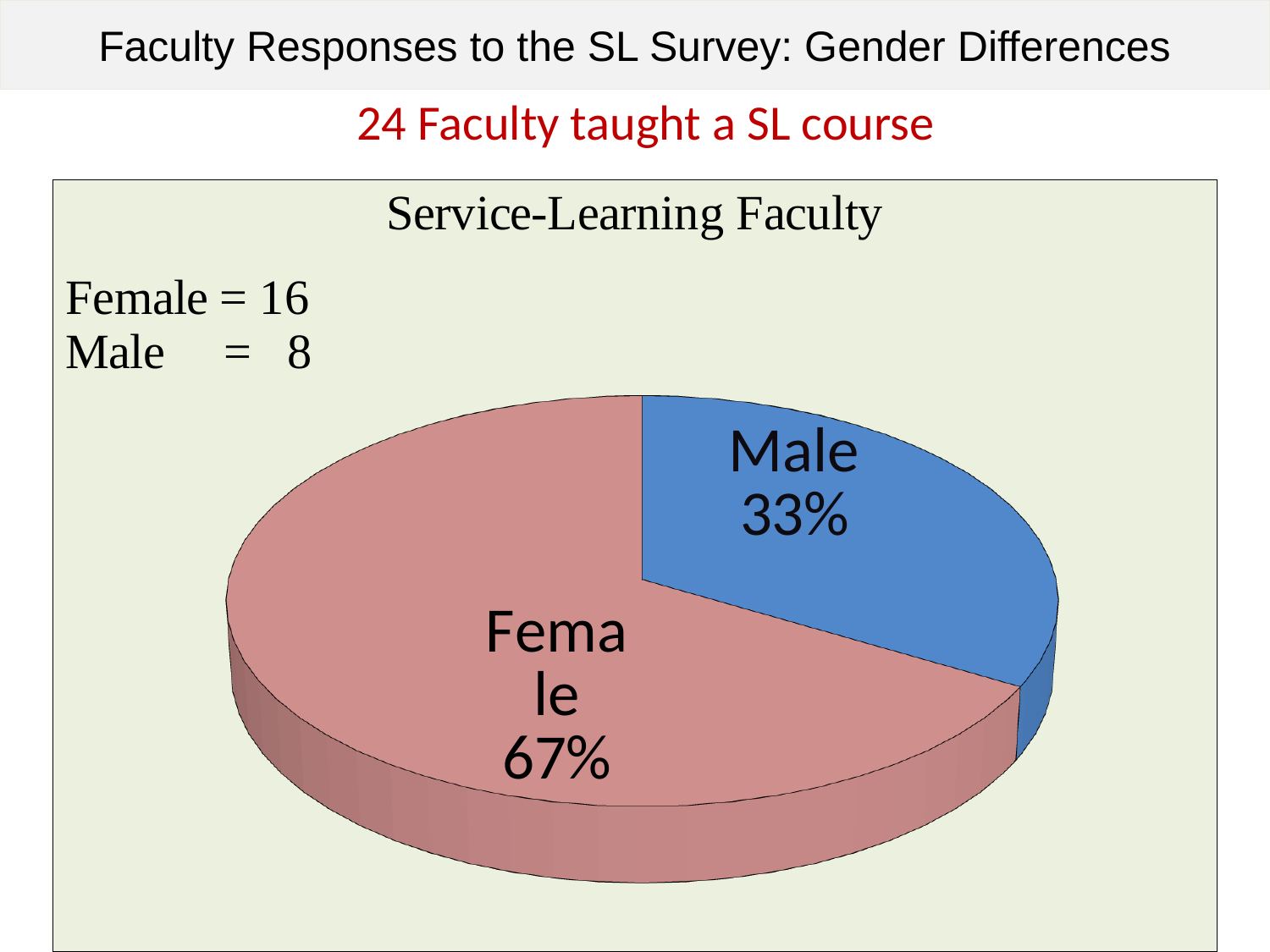
What share of the pie does the Male slice represent? 33% Which slice is larger, Female or Male? Female How many faculty are counted as Female according to the text in the chart area? 16 What share of the pie does the Female slice represent? 67% What colour is the Male slice of the pie chart? blue Which slice is the largest in the pie chart? Female What is the difference in percentage points between the Female and Male slices? 34 How many slices does the pie chart have? 2 How many faculty are counted as Male according to the text in the chart area? 8 What kind of chart is shown on the slide? pie chart Which slice is the smallest in the pie chart? Male What is the title of the chart? Service-Learning Faculty